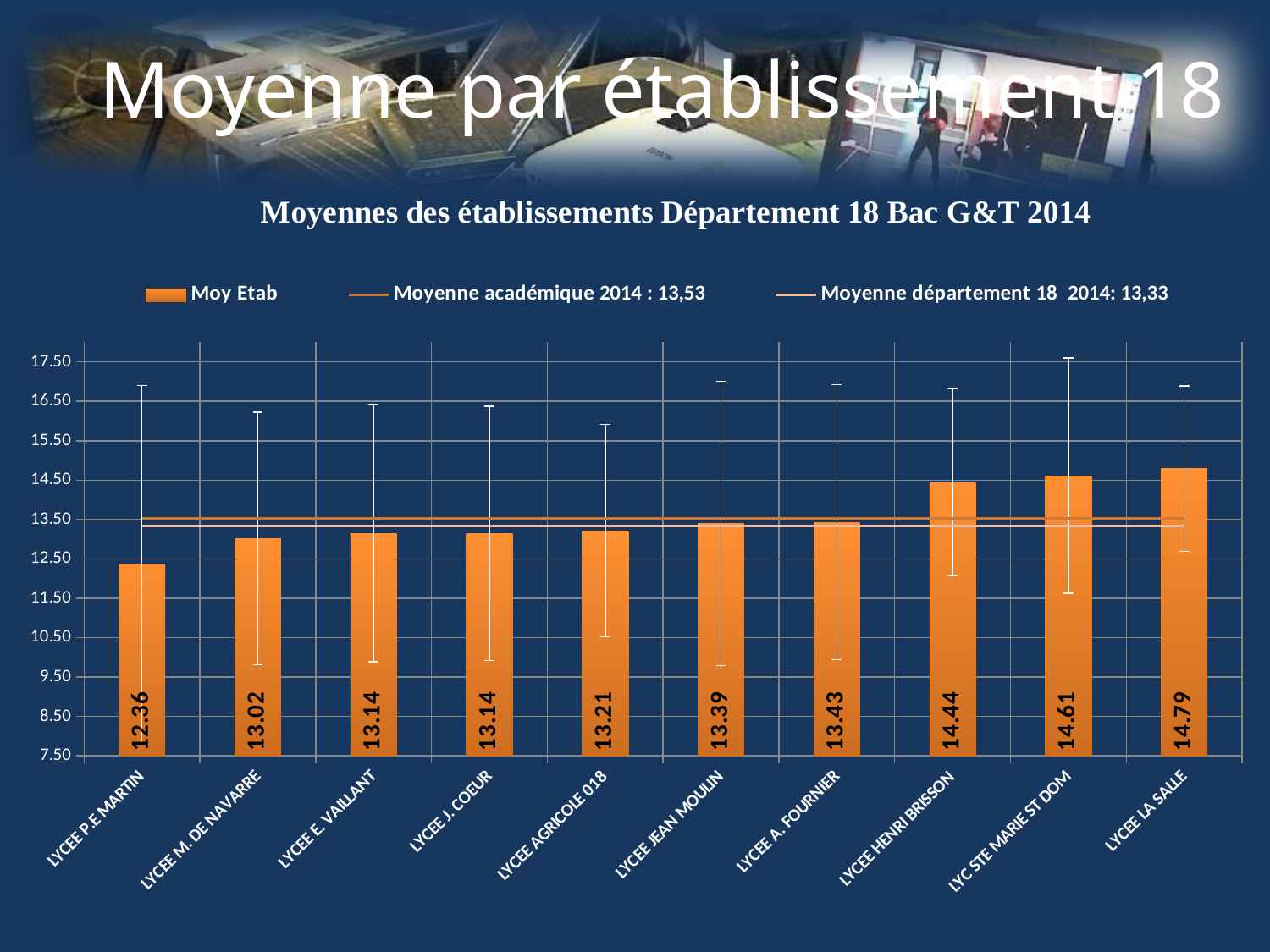
Which establishment has the lowest average? LYCEE P.E MARTIN What is the difference between the values for LYCEE LA SALLE and LYCEE P.E MARTIN? 2.43 Which is larger, the value for LYC STE MARIE ST DOM or the value for LYCEE JEAN MOULIN? LYC STE MARIE ST DOM Do the bar values rise or fall from left to right along the x axis? rise What is the value for LYCEE AGRICOLE 018? 13.21 Which establishment has the highest average? LYCEE LA SALLE What kind of chart is shown? bar chart How many establishments are shown on the chart? 10 What is the value for LYCEE P.E MARTIN? 12.36 What is the value for LYCEE HENRI BRISSON? 14.44 How many entries does the legend list? 3 What is the title of the chart? Moyennes des établissements Département 18 Bac G&T 2014